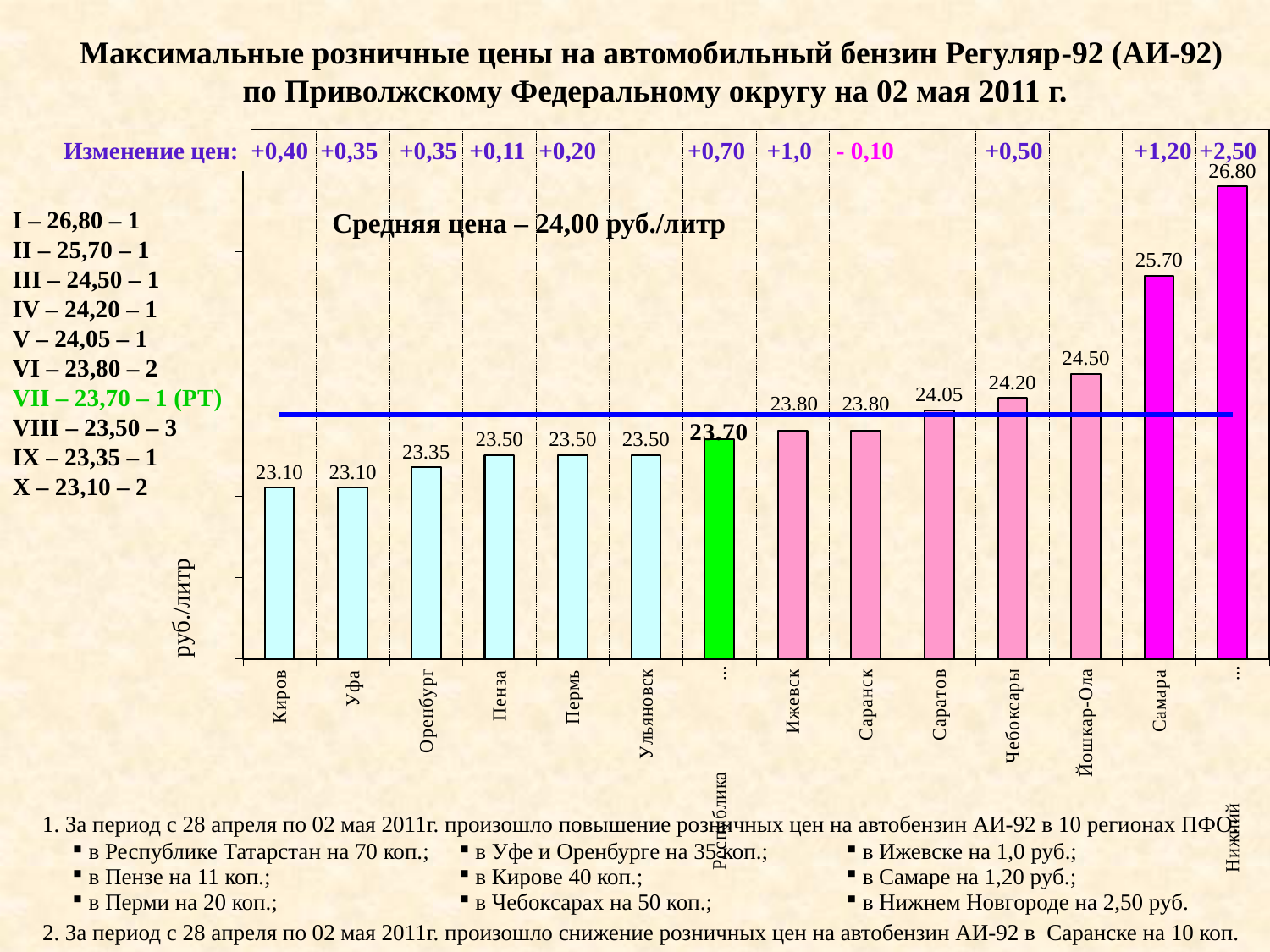
What type of chart is shown on the slide? bar chart What is the value for Йошкар-Ола? 24.50 Which category has the highest bar? Нижний (Новгород) What is the value for Саратов? 24.05 What average price is stated on the chart (Средняя цена)? 24,00 руб./литр What is the difference between the values for Самара and Йошкар-Ола? 1.20 What is the difference between the values for Чебоксары and Киров? 1.10 What is the value for Самара? 25.70 Do the values generally rise or fall from left to right along the x axis? rise How many bars are plotted in the chart? 14 What is the value for Оренбург? 23.35 Which is larger, the value for Ижевск or the value for Пенза? Ижевск